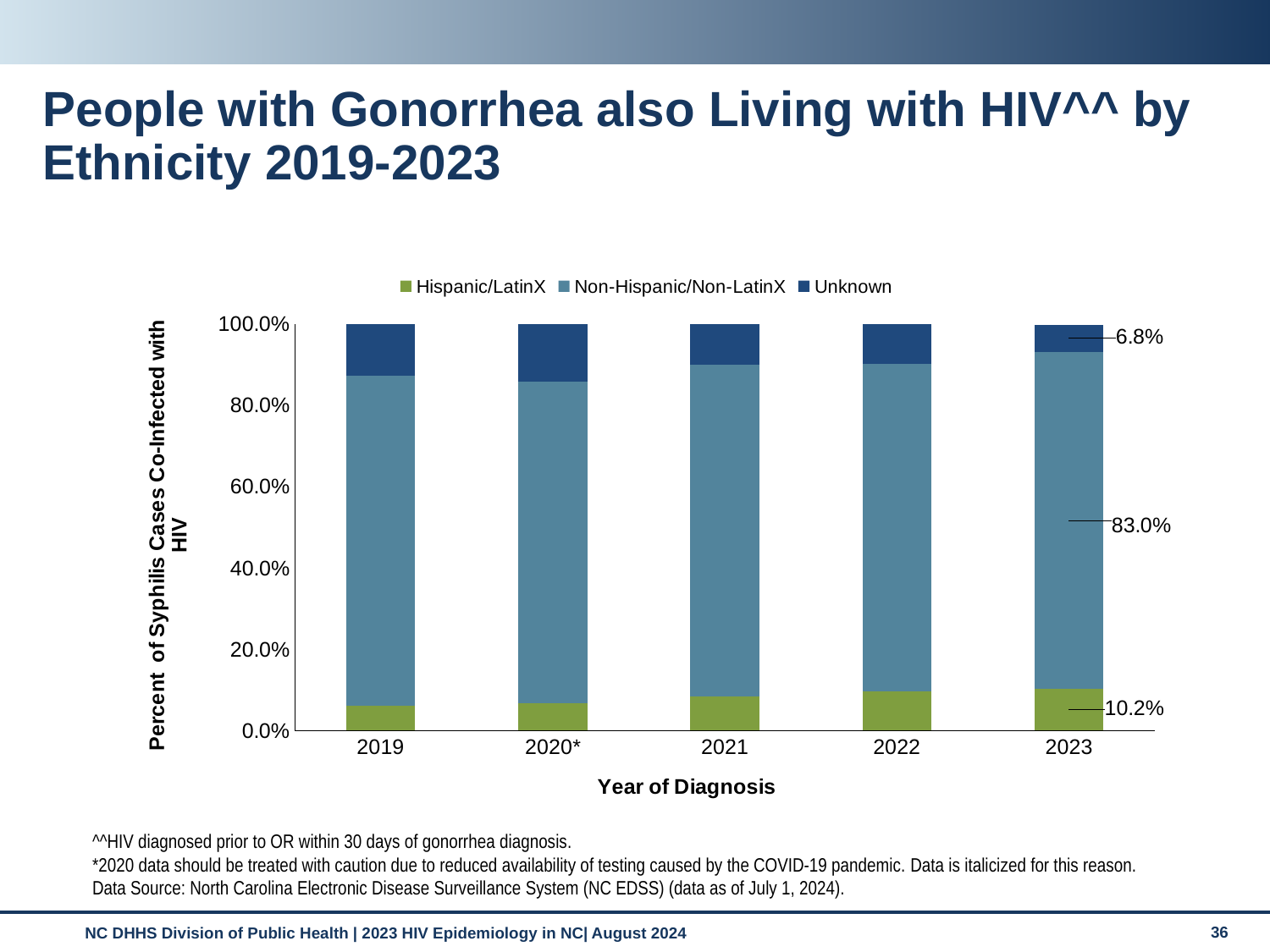
What is the Non-Hispanic/Non-LatinX value for 2023? 83.0% What is the Unknown value for 2023? 6.8% What kind of chart is shown on the slide? Stacked bar chart Which year has the smallest Unknown segment? 2023 Does the Hispanic/LatinX share rise or fall from 2019 to 2023? Rise Is the Hispanic/LatinX value for 2019 greater or less than 20.0%? less How many years are shown on the x axis? 5 What is the difference between the Non-Hispanic/Non-LatinX and Hispanic/LatinX values for 2023? 72.8% What is the Hispanic/LatinX value for 2023? 10.2% In 2023, which is larger: the Hispanic/LatinX value or the Unknown value? Hispanic/LatinX How many series does the legend list? 3 What is the title of the x axis? Year of Diagnosis